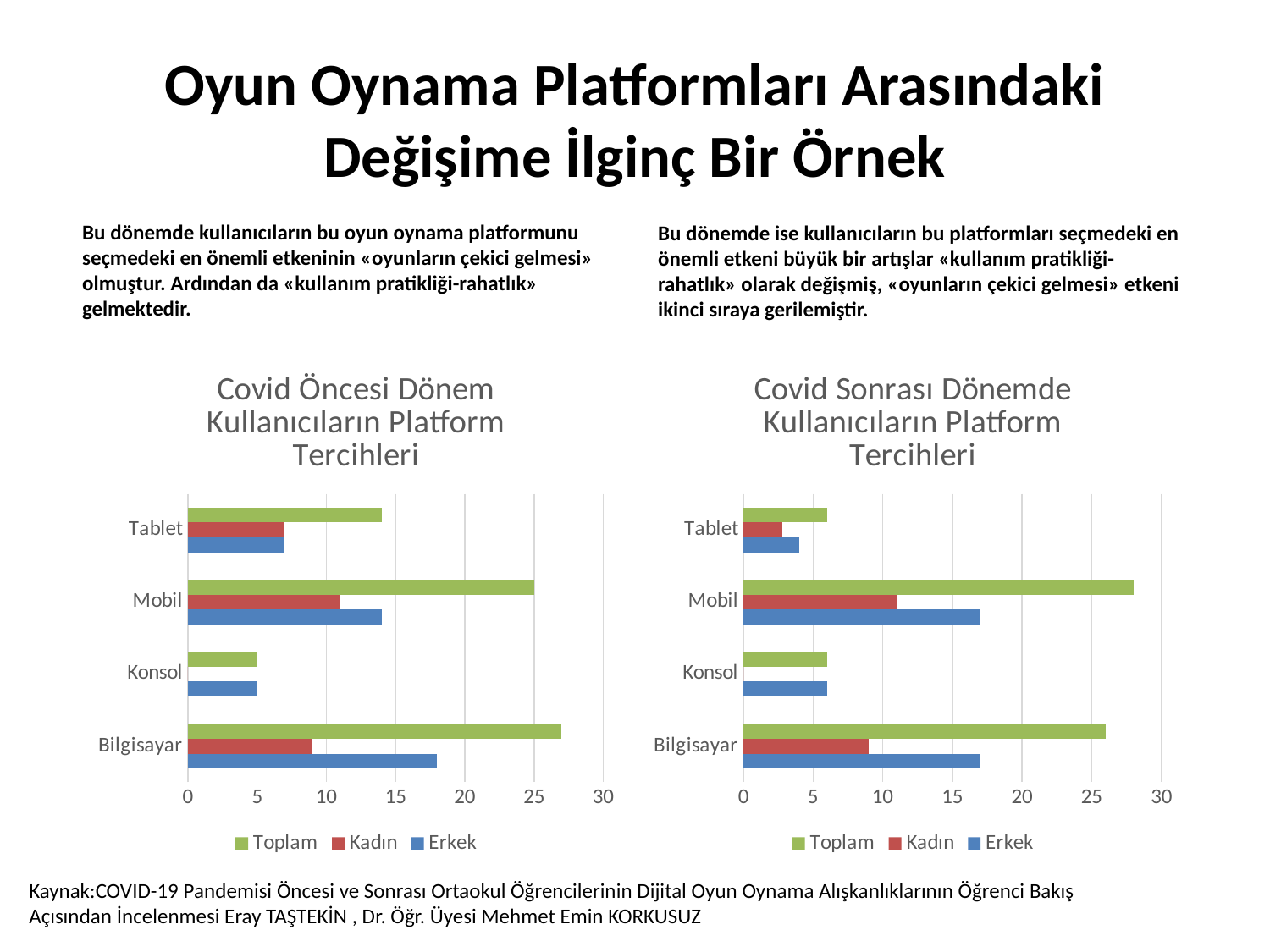
What are the three legend entries on the 'Covid Sonrası Dönemde Kullanıcıların Platform Tercihleri' chart? Toplam, Kadın, Erkek On the 'Covid Öncesi Dönem Kullanıcıların Platform Tercihleri' chart, what is the Toplam value for Konsol? 5 On the 'Covid Sonrası Dönemde Kullanıcıların Platform Tercihleri' chart, is the Toplam value for Mobil greater or less than 25? greater On the 'Covid Öncesi Dönem Kullanıcıların Platform Tercihleri' chart, which platform has the highest Toplam value? Bilgisayar On the 'Covid Öncesi Dönem Kullanıcıların Platform Tercihleri' chart, which has the larger Erkek value, Mobil or Tablet? Mobil On the 'Covid Öncesi Dönem Kullanıcıların Platform Tercihleri' chart, which platform has the lowest Toplam value? Konsol How many platform categories are shown on the 'Covid Sonrası Dönemde Kullanıcıların Platform Tercihleri' chart? 4 On the 'Covid Öncesi Dönem Kullanıcıların Platform Tercihleri' chart, is the Erkek value for Bilgisayar greater or less than 15? greater What kind of chart is the 'Covid Öncesi Dönem Kullanıcıların Platform Tercihleri' chart? bar chart On the 'Covid Sonrası Dönemde Kullanıcıların Platform Tercihleri' chart, which platform has the highest Toplam value? Mobil On the 'Covid Sonrası Dönemde Kullanıcıların Platform Tercihleri' chart, is the Toplam value for Tablet greater or less than 10? less How many series does the legend of the 'Covid Öncesi Dönem Kullanıcıların Platform Tercihleri' chart list? 3